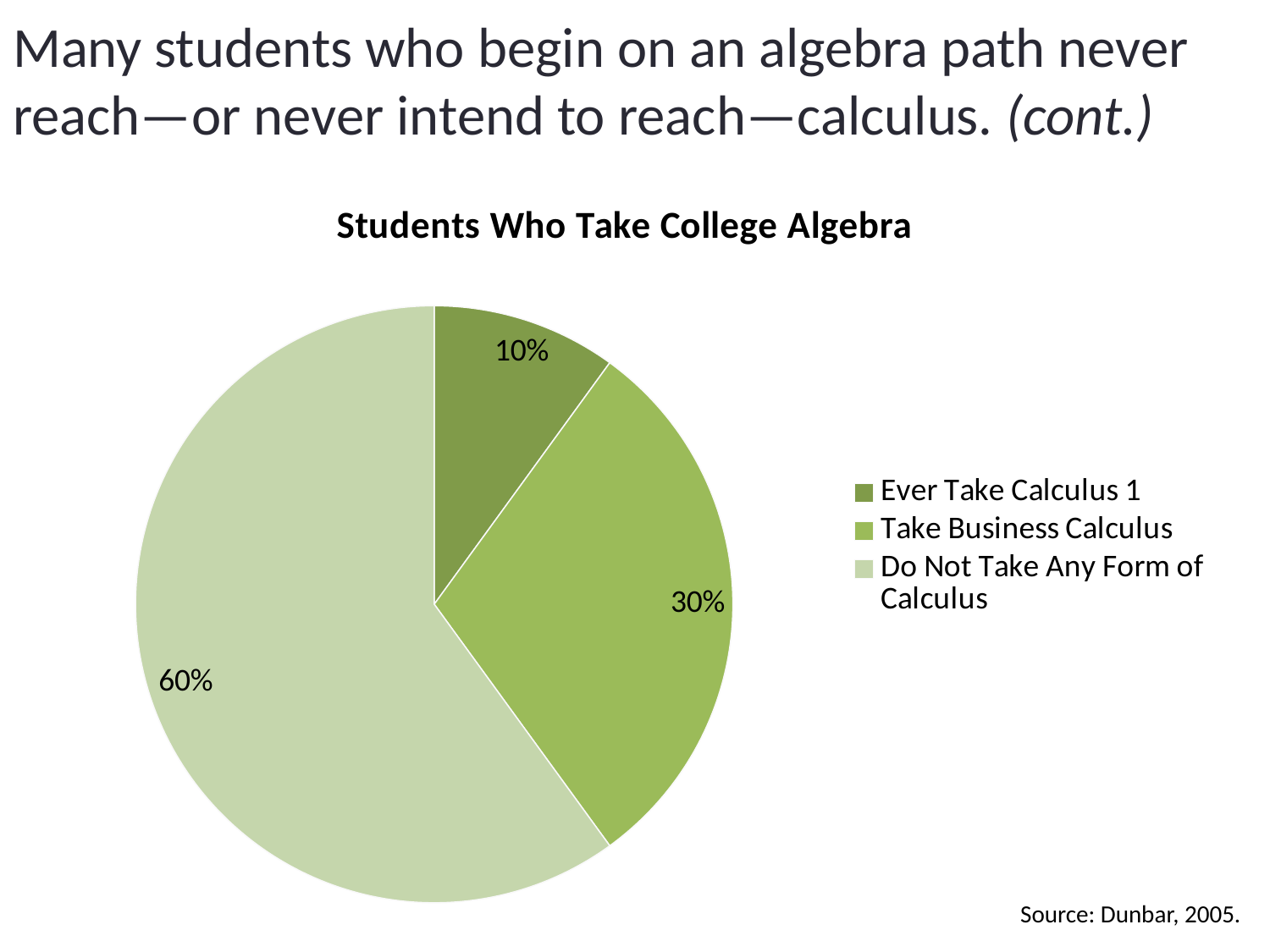
What percentage of students Ever Take Calculus 1? 10% Which category has the smallest share of the pie? Ever Take Calculus 1 How many categories does the pie chart have? 3 What percentage of students Take Business Calculus? 30% Which category has the largest share of the pie? Do Not Take Any Form of Calculus How many entries does the legend list? 3 What is the title of the chart? Students Who Take College Algebra Which is larger: the share for Take Business Calculus or the share for Ever Take Calculus 1? Take Business Calculus What percentage of students Do Not Take Any Form of Calculus? 60% What is the combined percentage of students who take some form of calculus (Calculus 1 or Business Calculus)? 40% What is the difference in percentage points between Do Not Take Any Form of Calculus and Take Business Calculus? 30 percentage points What kind of chart is shown on the slide? Pie chart